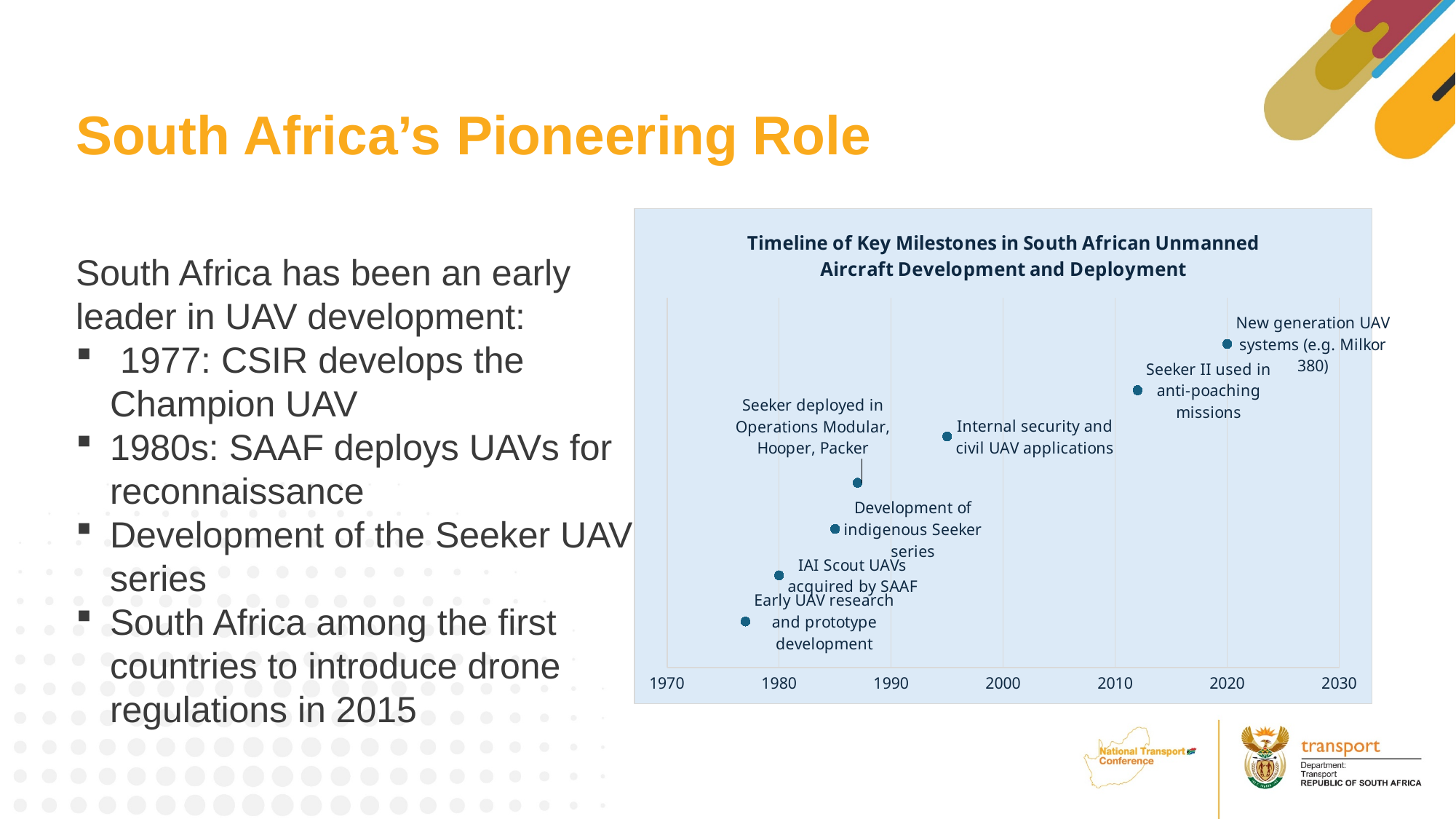
What is the title of the chart? Timeline of Key Milestones in South African Unmanned Aircraft Development and Deployment Is the year for 'Seeker II used in anti-poaching missions' greater or less than 2010? greater Is the year for 'Early UAV research and prototype development' greater or less than 1980? less What is the range of years shown on the x axis of the chart? 1970 to 2030 Which milestone is the earliest on the timeline? Early UAV research and prototype development Which milestone is the latest on the timeline? New generation UAV systems (e.g. Milkor 380) Is the year for 'New generation UAV systems (e.g. Milkor 380)' greater or less than 2010? greater Which milestone occurs earlier: 'Internal security and civil UAV applications' or 'Seeker II used in anti-poaching missions'? Internal security and civil UAV applications How many milestone points are plotted on the chart? 7 What kind of chart is shown on the slide? scatter chart